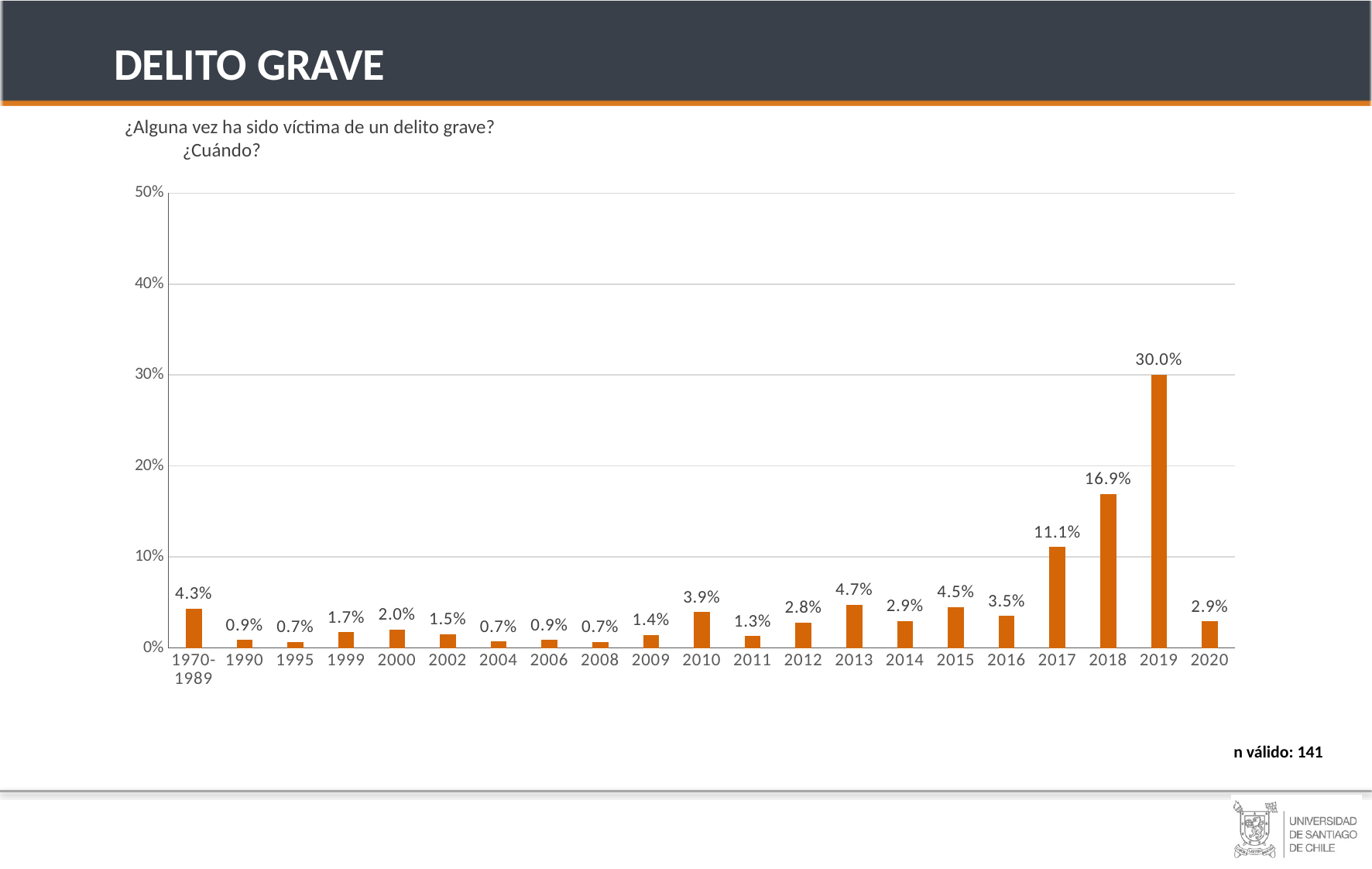
What is the value for 2019? 30.0% Is the value for 2018 greater or less than 20%? less What is the valid n stated on the slide? 141 What is the value for 2013? 4.7% What is the difference between the values for 2019 and 2018? 13.1% Which is larger, the value for 2010 or the value for 2012? 2010 How many categories are shown on the x axis? 21 Which year has the highest value? 2019 What is the value for 2017? 11.1% What kind of chart is shown on the slide? bar chart What is the value for the 1970-1989 period? 4.3% What is the lowest value shown on the chart? 0.7%